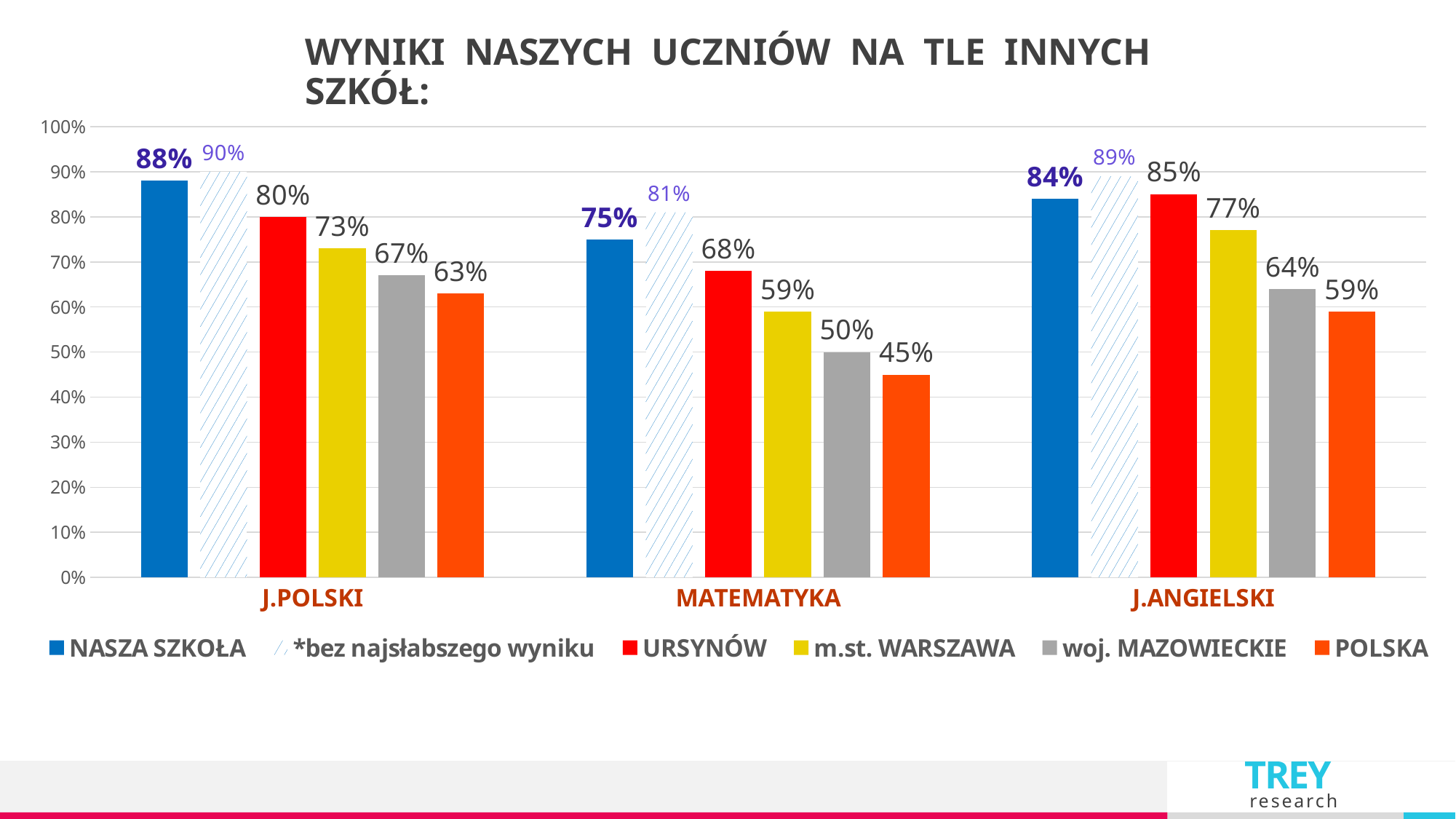
What kind of chart is shown on the slide? bar chart Which category has the lowest value for woj. MAZOWIECKIE? MATEMATYKA How many series does the legend list? 6 How many categories are shown on the x axis? 3 What is the value for *bez najsłabszego wyniku in MATEMATYKA? 81% Which category has the highest value for m.st. WARSZAWA? J.ANGIELSKI What is the value for URSYNÓW in J.ANGIELSKI? 85% What is the difference between NASZA SZKOŁA and POLSKA in MATEMATYKA? 30% What is the value for POLSKA in MATEMATYKA? 45% What colour are the POLSKA bars? orange Which is larger in J.ANGIELSKI: NASZA SZKOŁA or URSYNÓW? URSYNÓW What is the value for NASZA SZKOŁA in J.POLSKI? 88%